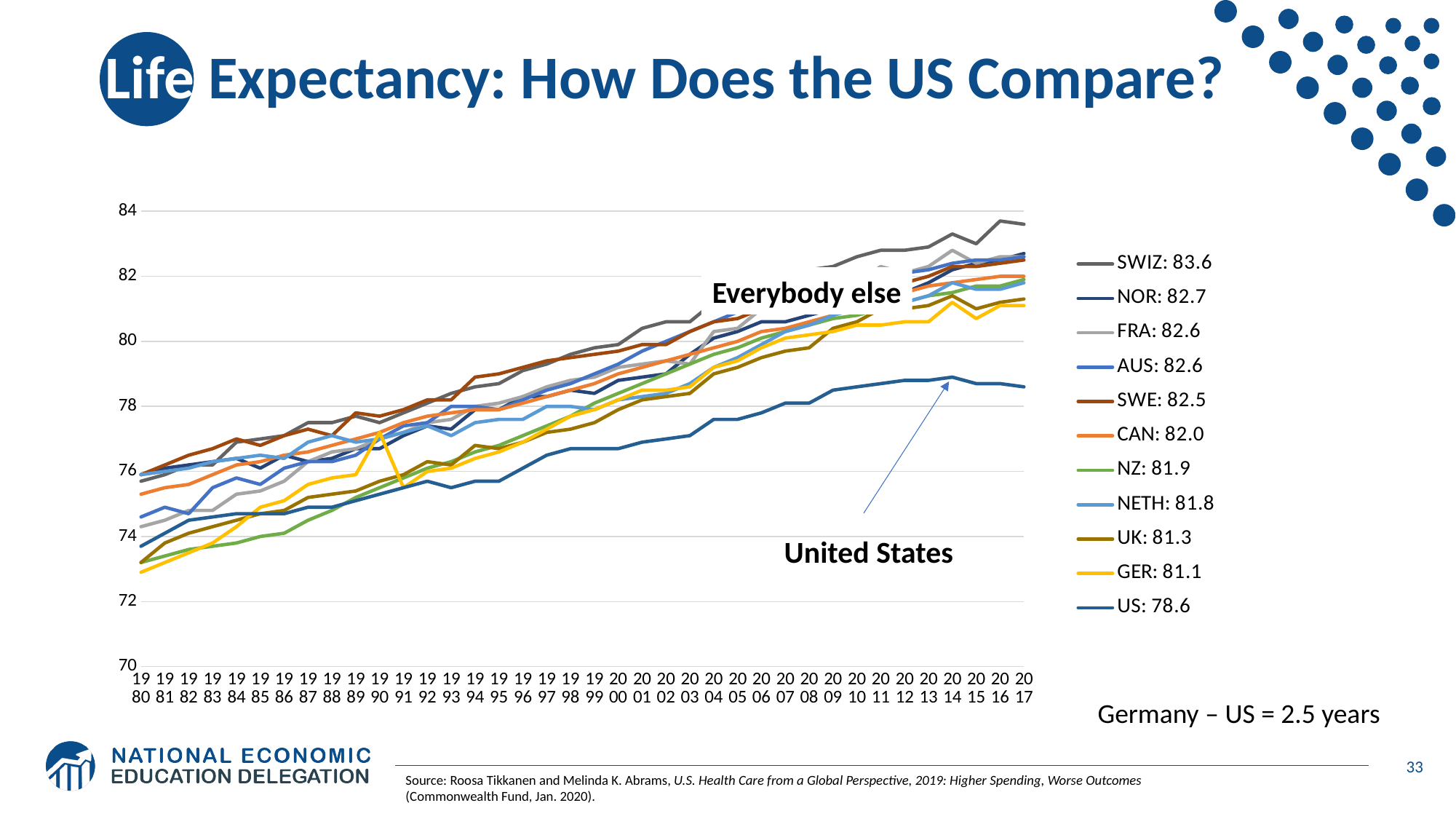
What is the last year shown on the x axis? 2017 What life expectancy value is shown for the US in the legend? 78.6 How many series does the legend list? 11 What is the difference between the SWIZ value and the US value shown in the legend? 5.0 Is the value for the US line in 2000 greater or less than 78? less What life expectancy value is shown for SWIZ in the legend? 83.6 Which has a higher value in the legend, NOR or UK? NOR Which country has the lowest life expectancy value in the legend? US Does the US line rise or fall from 1980 to 2017? rise Which country has the highest life expectancy value in the legend? SWIZ According to the slide, what is the difference between Germany and the US in years? 2.5 years What kind of chart is shown on the slide? line chart